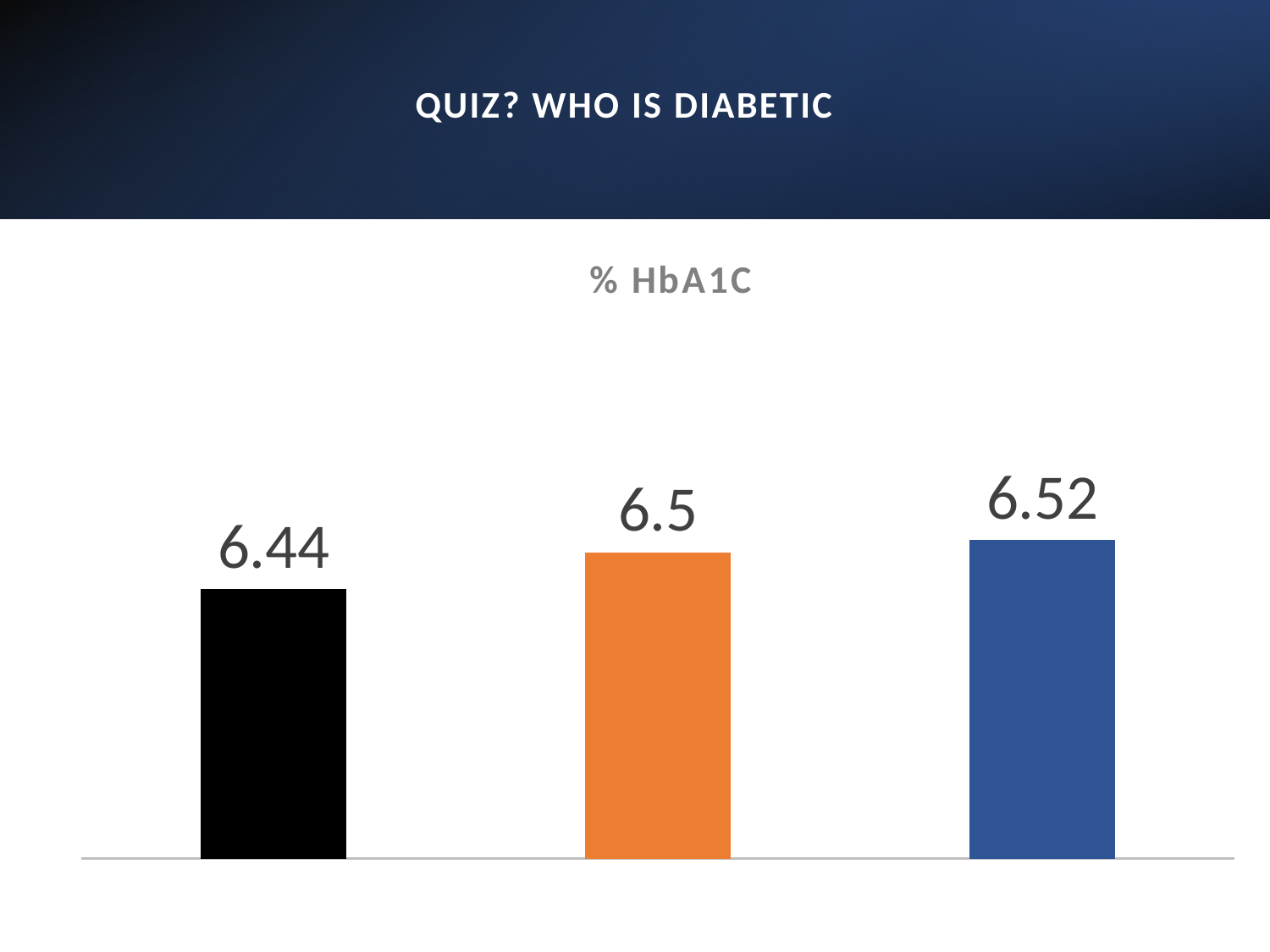
What type of chart is shown on the slide? bar chart Do the bar values rise or fall from left to right? rise Which bar has the lowest value? the black bar (leftmost), 6.44 Which is larger, the value of the orange bar or the value of the black bar? the orange bar What is the difference between the rightmost bar's value and the leftmost bar's value? 0.08 What is the difference between the middle bar's value and the leftmost bar's value? 0.06 What is the title of the chart? % HbA1C What is the value shown on the black bar (leftmost)? 6.44 How many bars are plotted in the chart? 3 What is the value shown on the orange bar (middle)? 6.5 What is the value shown on the blue bar (rightmost)? 6.52 Which bar has the highest value? the blue bar (rightmost), 6.52